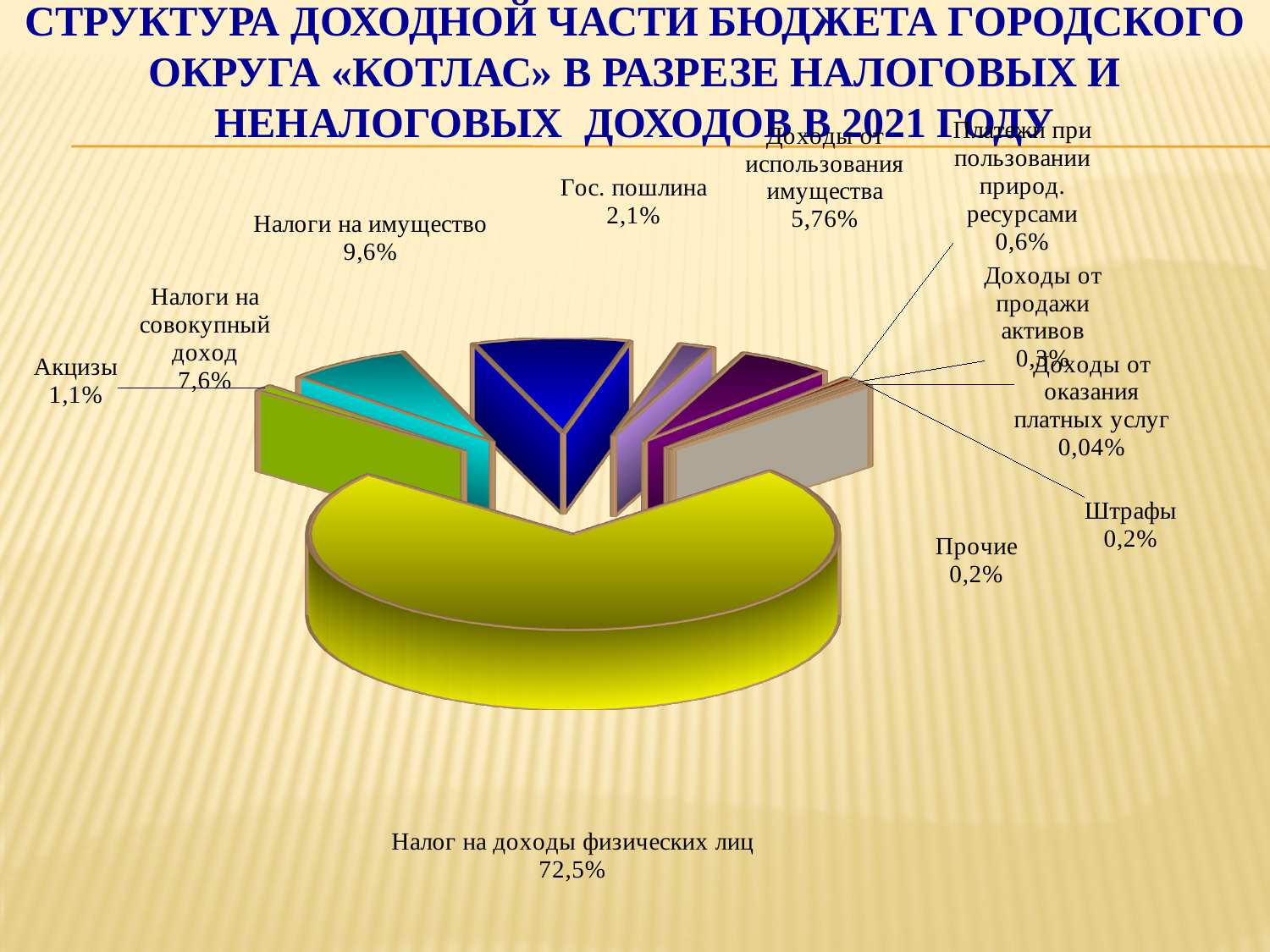
What is the value shown for Налоги на имущество? 9,6% What is the value shown for Доходы от использования имущества? 5,76% What is the difference in percentage points between Налоги на имущество and Налоги на совокупный доход? 2,0 Which category has the largest share of the pie? Налог на доходы физических лиц What share of the budget revenue comes from Налог на доходы физических лиц? 72,5% What kind of chart is shown on the slide? pie chart Which category has the smallest share of the pie? Доходы от оказания платных услуг Which is larger: the share for Гос. пошлина or the share for Акцизы? Гос. пошлина Which year does the chart title say the budget revenue structure refers to? 2021 What is the value shown for Акцизы? 1,1% What is the value shown for Гос. пошлина? 2,1% What is the value shown for Налоги на совокупный доход? 7,6%